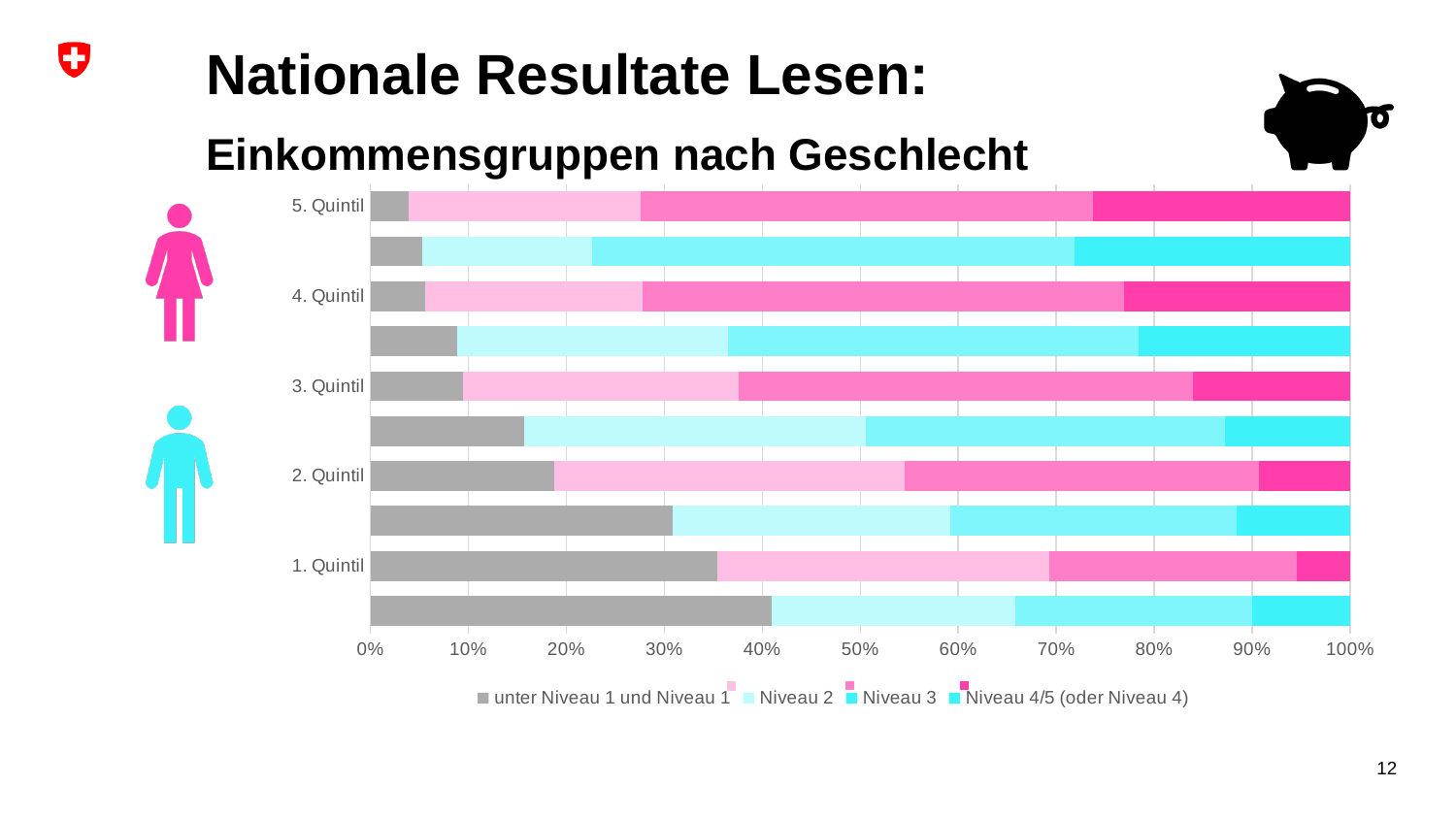
How many series does the chart legend list? 4 Is the grey segment of the cyan bar below 1. Quintil greater or less than 30%? greater How many quintile categories are labelled on the vertical axis of the chart? 5 What is the total of each stacked bar in the chart? 100% Is the grey 'unter Niveau 1 und Niveau 1' segment of the pink bar for 5. Quintil greater or less than 10%? less Which quintile has the largest grey 'unter Niveau 1 und Niveau 1' segment in its pink bar? 1. Quintil What is the last entry listed in the chart legend? Niveau 4/5 (oder Niveau 4) Which quintile has the smallest grey 'unter Niveau 1 und Niveau 1' segment in its pink bar? 5. Quintil Which has a larger grey 'unter Niveau 1 und Niveau 1' segment: the pink bar for 1. Quintil or the pink bar for 5. Quintil? 1. Quintil Is the grey 'unter Niveau 1 und Niveau 1' segment of the pink bar for 1. Quintil greater or less than 30%? greater Going from 1. Quintil up to 5. Quintil, does the grey 'unter Niveau 1 und Niveau 1' share of the pink bars rise or fall? fall What kind of chart is shown on the slide? stacked bar chart